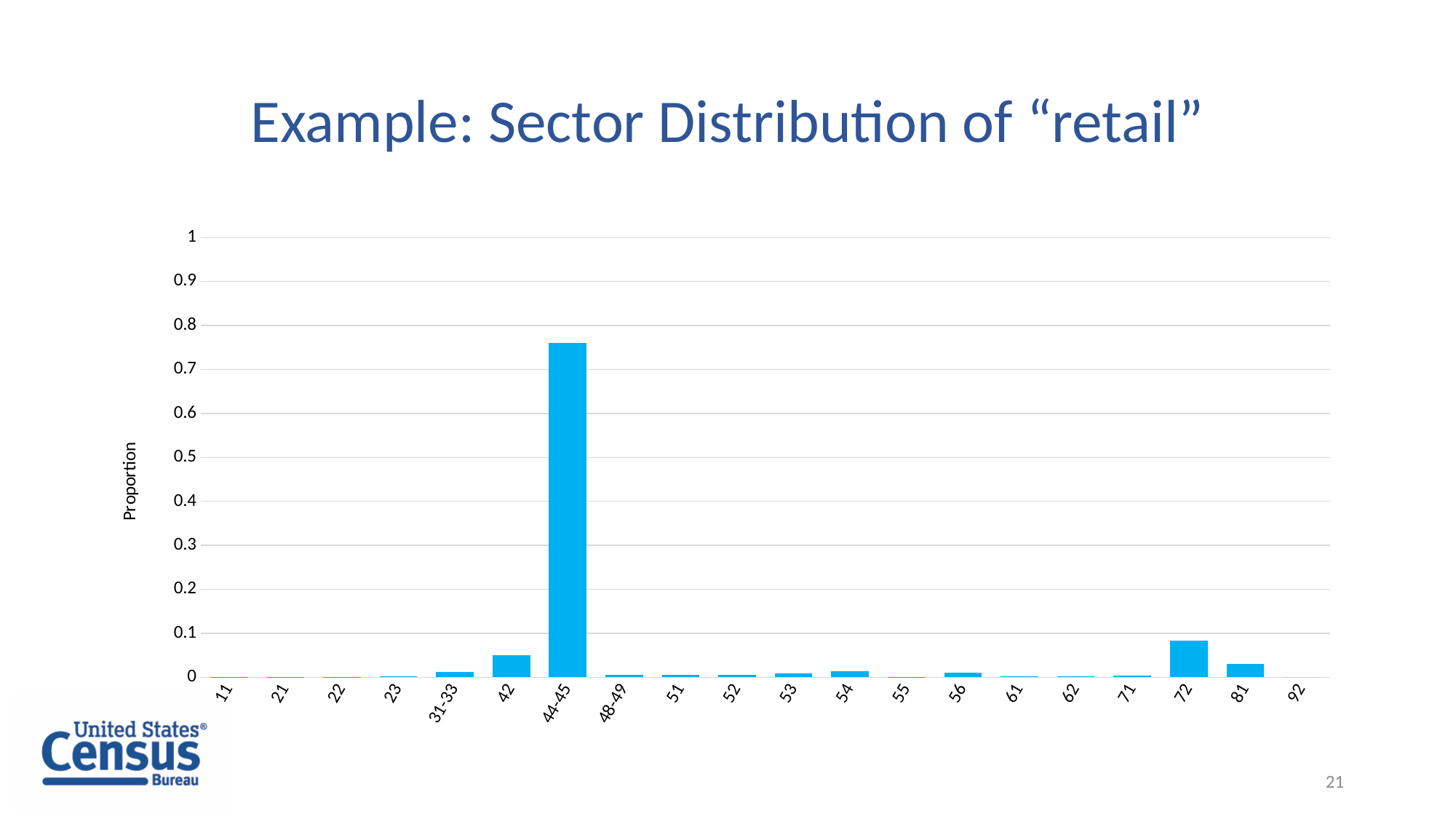
What is the label of the y axis? Proportion Which sector has the larger proportion, 42 or 72? 72 Which sector has the larger proportion, 44-45 or 42? 44-45 Which sector has the larger proportion, 72 or 81? 72 What kind of chart is shown on the slide? bar chart Which sector has the highest proportion? 44-45 Is the proportion for sector 44-45 greater or less than 0.7? greater Is the proportion for sector 72 greater or less than 0.1? less Is the proportion for sector 44-45 greater or less than 0.8? less How many sector categories are shown on the x axis? 20 What is the title of the slide? Example: Sector Distribution of "retail"